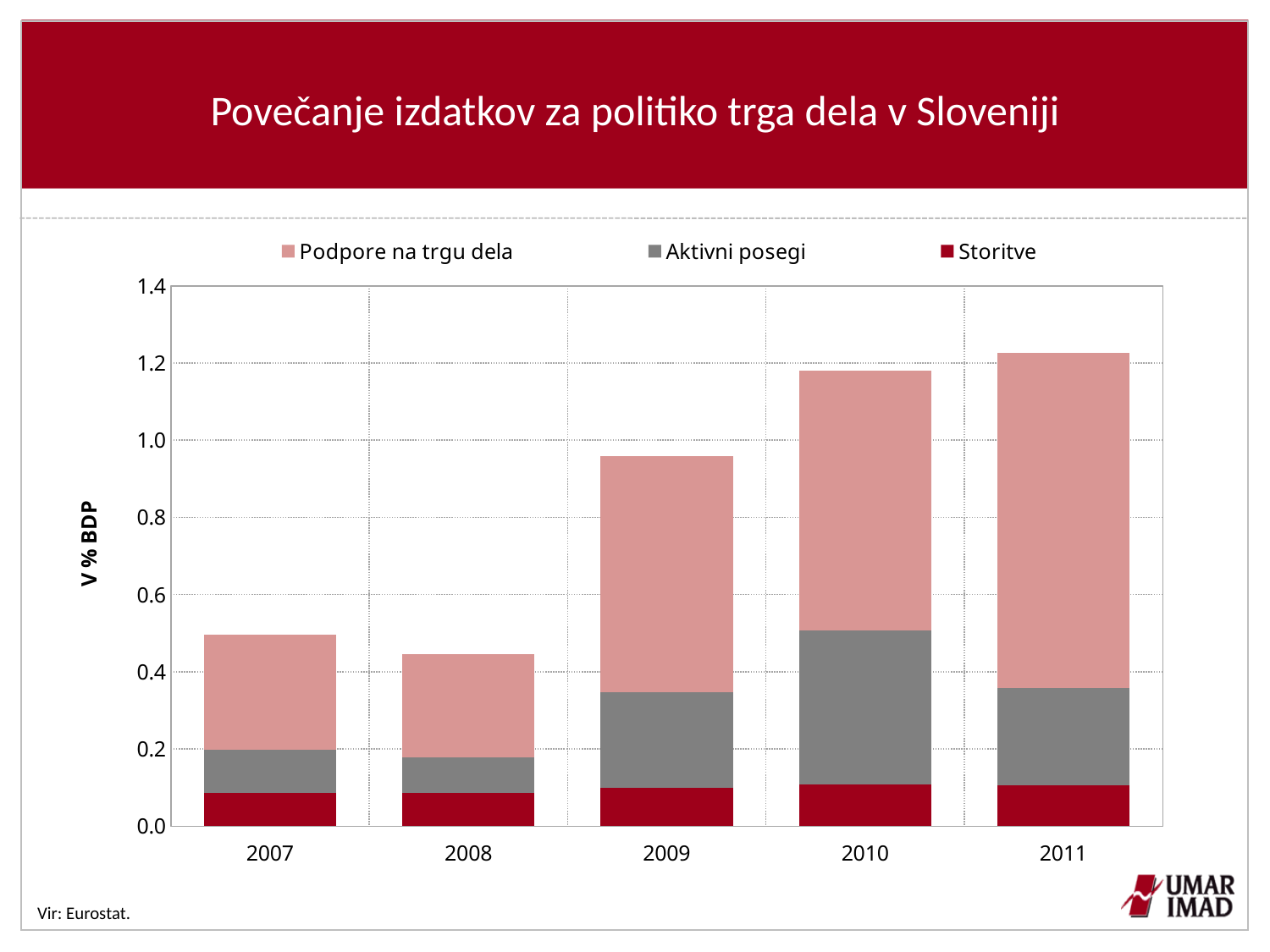
What is the label on the y axis of the chart? V % BDP Is the total value for 2008 greater or less than 0.6? less Is the total value for 2009 greater or less than 1.0? less Which year has the highest total bar? 2011 How many years are shown on the x axis of the chart? 5 Which year has the larger Aktivni posegi segment, 2010 or 2011? 2010 Is the total value for 2010 greater or less than 1.0? greater What kind of chart is shown on the slide? Stacked bar chart From 2008 to 2011, do the total bars rise or fall? rise Which year has the lowest total bar? 2008 How many series does the chart's legend list? 3 Which year has the larger total bar, 2008 or 2009? 2009